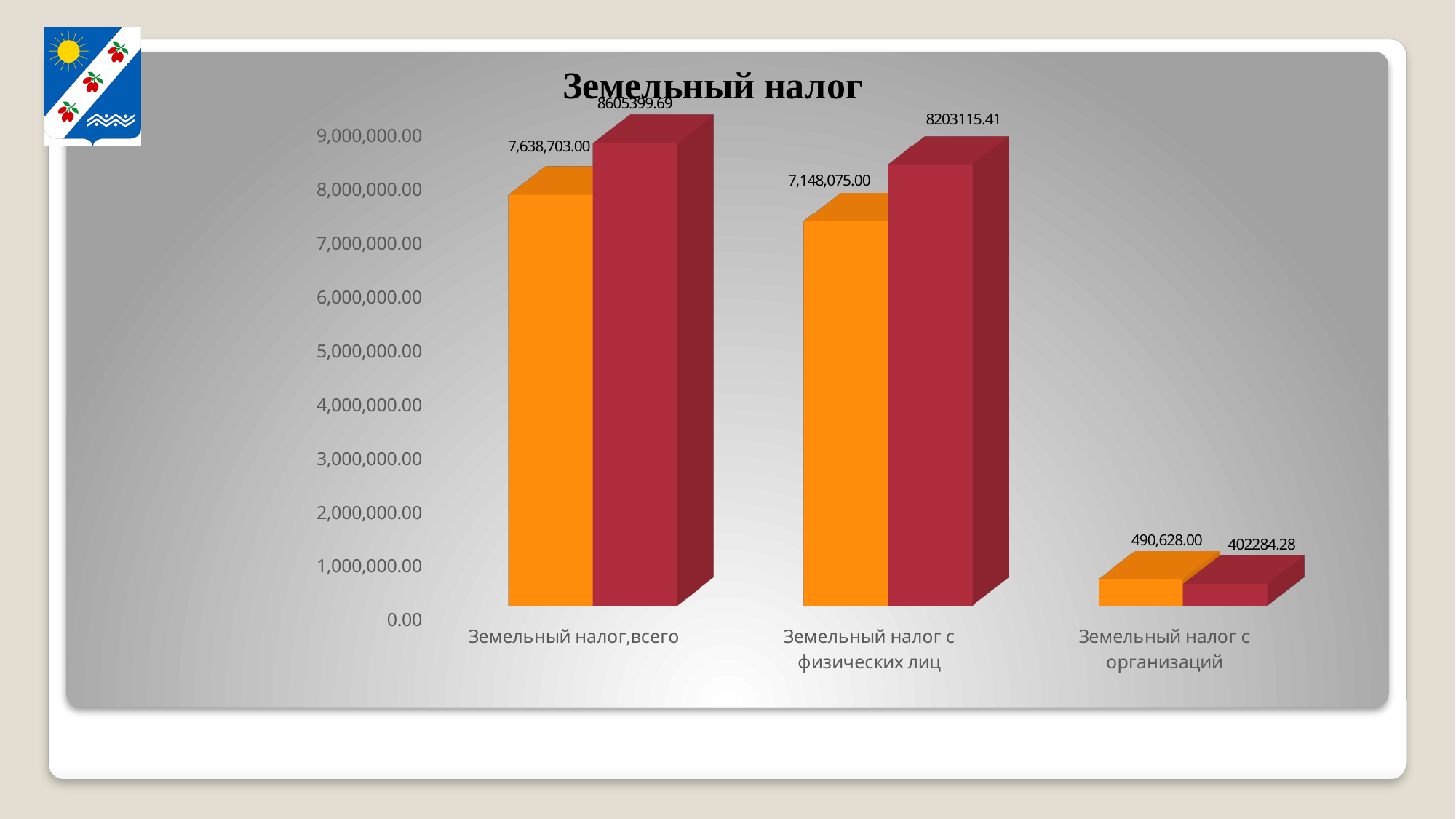
What is the value of the orange bar for "Земельный налог,всего"? 7,638,703.00 What is the value of the orange bar for "Земельный налог с организаций"? 490,628.00 What is the value of the red bar for "Земельный налог с физических лиц"? 8203115.41 Which category has the lowest values in the chart? Земельный налог с организаций Is the red bar for "Земельный налог с физических лиц" greater or less than 8,000,000.00? greater What is the value of the orange bar for "Земельный налог с физических лиц"? 7,148,075.00 How many categories are shown on the x axis of the chart? 3 What is the value of the red bar for "Земельный налог с организаций"? 402284.28 What is the title of the chart? Земельный налог What kind of chart is shown on the slide? bar chart What is the value of the red bar for "Земельный налог,всего"? 8605399.69 For "Земельный налог с организаций", which bar is larger, the orange one or the red one? the orange one